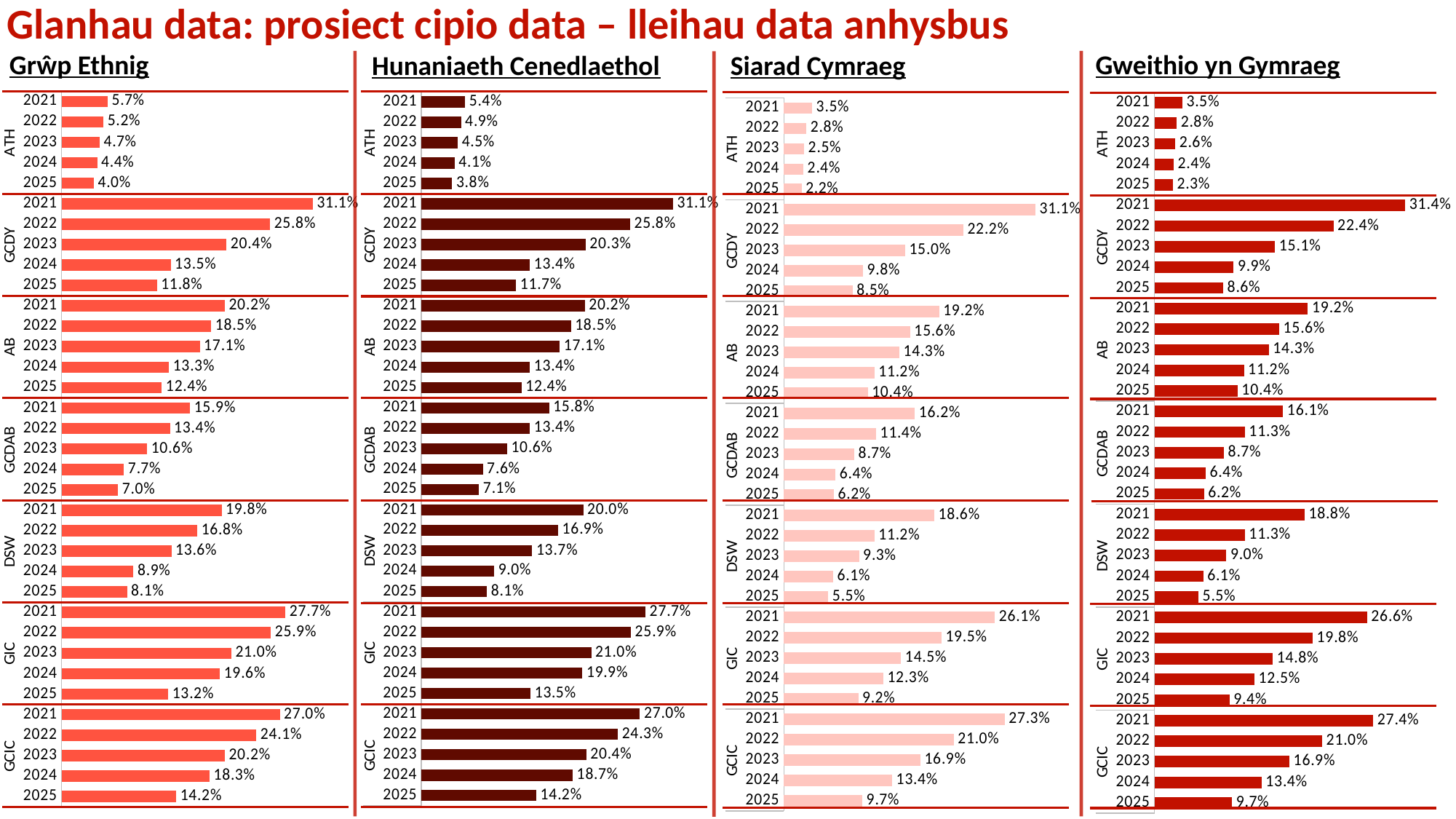
In the Gweithio yn Gymraeg chart, what is the value for GCIC in 2022? 21.0% In the Hunaniaeth Cenedlaethol chart, what is the value for DSW in 2023? 13.7% In the Siarad Cymraeg chart, what is the value for GIC in 2025? 9.2% What kind of chart is the Gweithio yn Gymraeg chart? bar chart How many charts are shown on the slide? 4 In the Grŵp Ethnig chart, which year has the lowest value for ATH? 2025 In the Siarad Cymraeg chart, what is the difference between the GCDY values for 2021 and 2025? 22.6% In the Grŵp Ethnig chart, what is the value for GCDY in 2021? 31.1% How many years are shown for each group in the Siarad Cymraeg chart? 5 In the Grŵp Ethnig chart, do the values for AB rise or fall from 2021 to 2025? fall In the Gweithio yn Gymraeg chart, which year has the highest value for GCDY? 2021 In the Hunaniaeth Cenedlaethol chart, which is larger: the GIC value for 2022 or the GCIC value for 2022? GIC 2022 (25.9%)